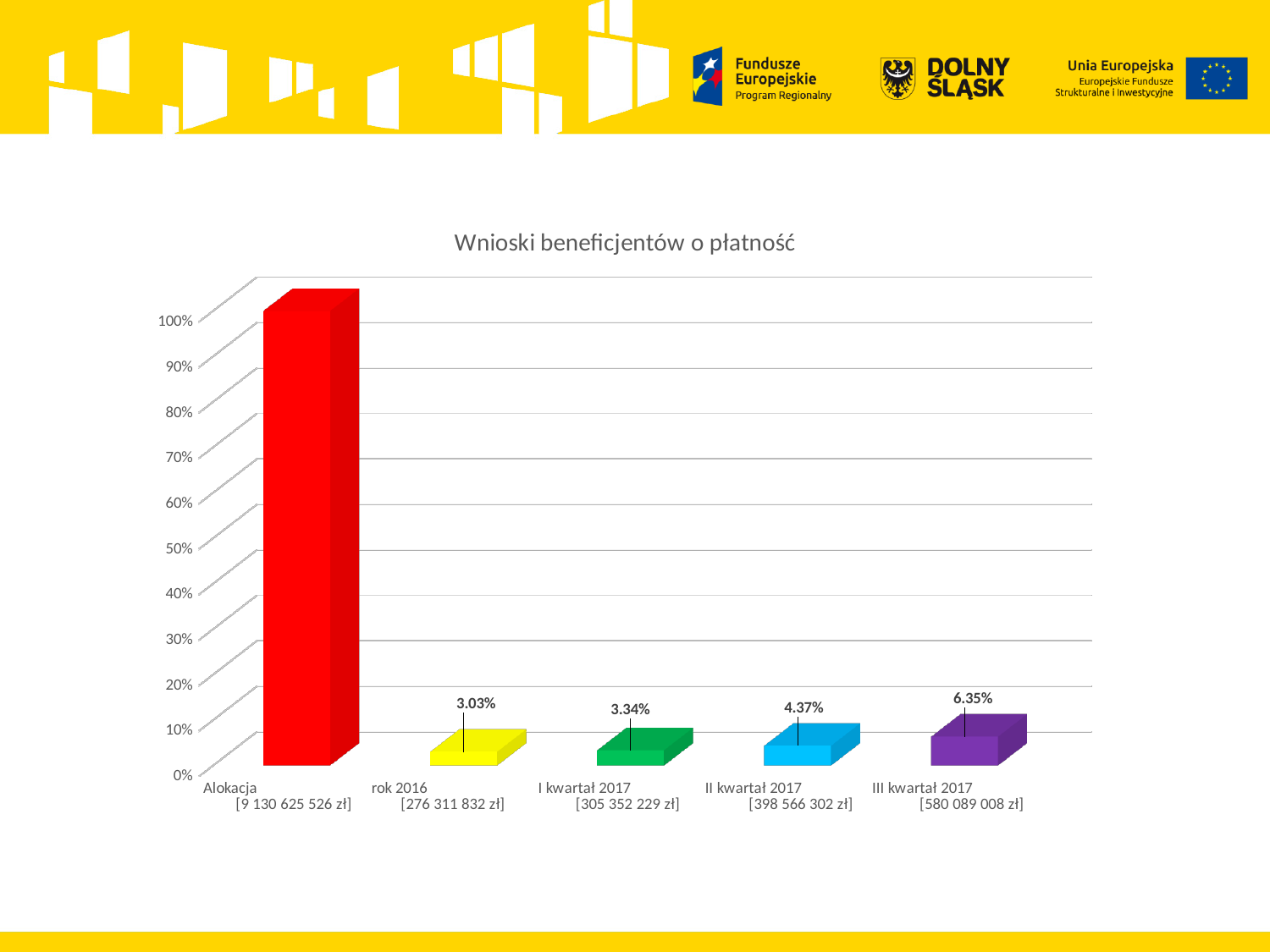
Which is larger, the value for II kwartał 2017 or for I kwartał 2017? II kwartał 2017 What is the value shown for I kwartał 2017? 3.34% What is the difference between the values for III kwartał 2017 and rok 2016? 3.32% Is the value for Alokacja greater or less than 90%? greater What is the value shown for rok 2016? 3.03% Which category has the tallest bar? Alokacja What kind of chart is shown on the slide? bar chart What is the value shown for II kwartał 2017? 4.37% What is the title of the chart? Wnioski beneficjentów o płatność What is the value shown for III kwartał 2017? 6.35% How many bars are shown in the chart? 5 Which category has the lowest value? rok 2016